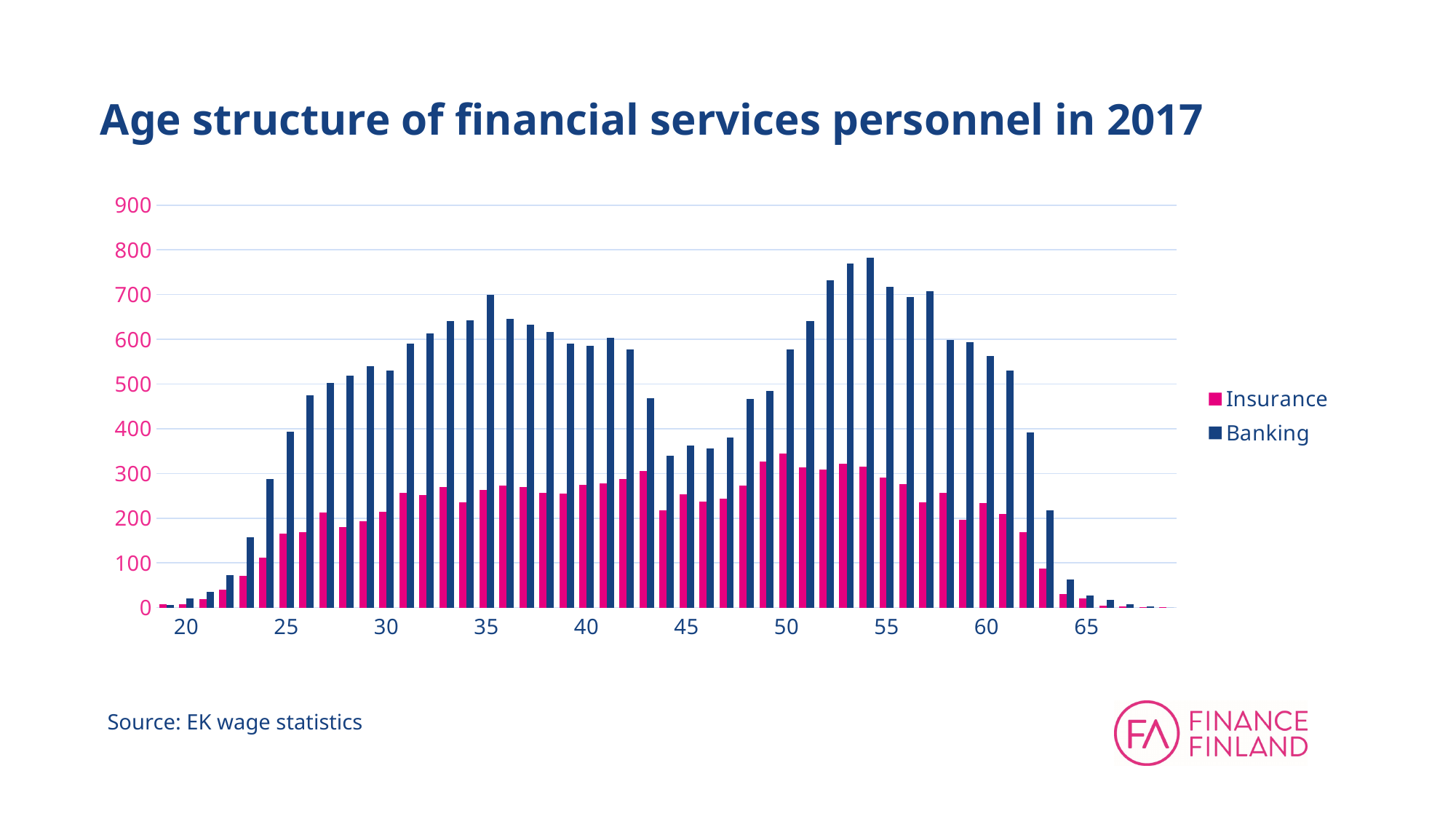
Which series is shown in pink/magenta bars? Insurance What kind of chart is shown on the slide? bar chart Do the Banking values rise or fall from age 45 to age 54? rise Is the Insurance value at age 65 greater or less than 100? less At which age is the Banking value highest? 54 Is the Banking value at age 30 greater or less than 500? greater How many series does the legend list? 2 Is the Banking value at age 45 greater or less than 400? less What is the title of the chart? Age structure of financial services personnel in 2017 At which age is the Insurance value highest? 50 At age 35, which series has the larger value, Banking or Insurance? Banking